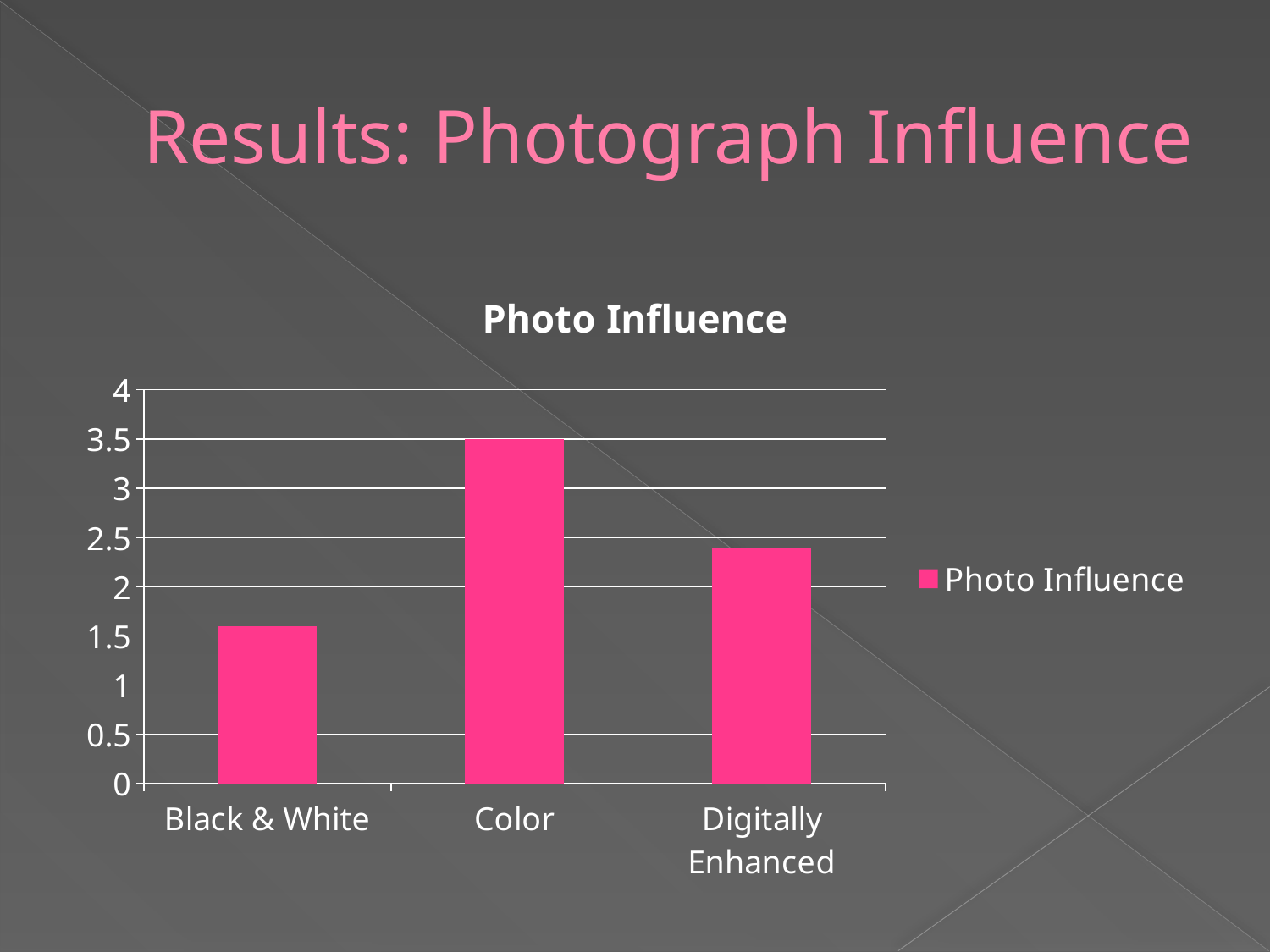
Which is larger, the value for Color or the value for Digitally Enhanced? Color What is the value for Color? 3.5 How many categories are shown on the x axis of the chart? 3 Which category has the lowest value? Black & White What is the name of the series shown in the legend? Photo Influence What kind of chart is shown on the slide? bar chart Which category has the highest value? Color Is the value for Digitally Enhanced greater or less than 3? less How many series does the legend list? 1 Is the value for Digitally Enhanced greater or less than 2? greater Is the value for Black & White greater or less than 2? less What is the title of the chart? Photo Influence